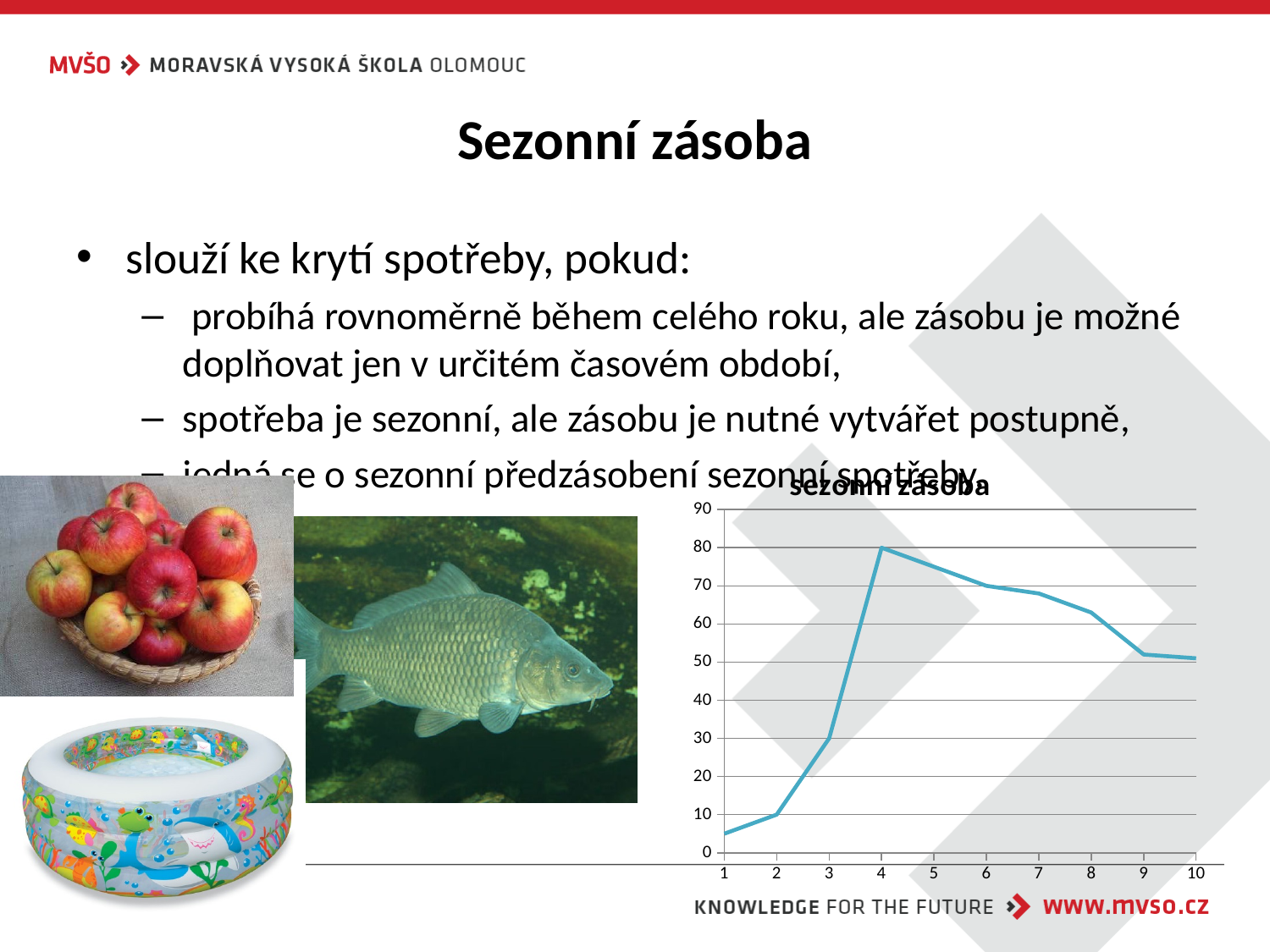
Is the value at category 9 greater or less than 60? less Is the value at category 1 greater or less than 10? less Is the value at category 3 greater or less than 40? less What is the value at category 4? 80 Do the values rise or fall from category 4 to category 10? fall At which x-axis category does the line have its lowest value? 1 Which has the larger value, category 2 or category 8? 8 At which x-axis category does the line reach its highest value? 4 How many points are plotted along the x axis of the chart? 10 What is the title of the chart? sezonní zásoba What kind of chart is shown on the slide? line chart